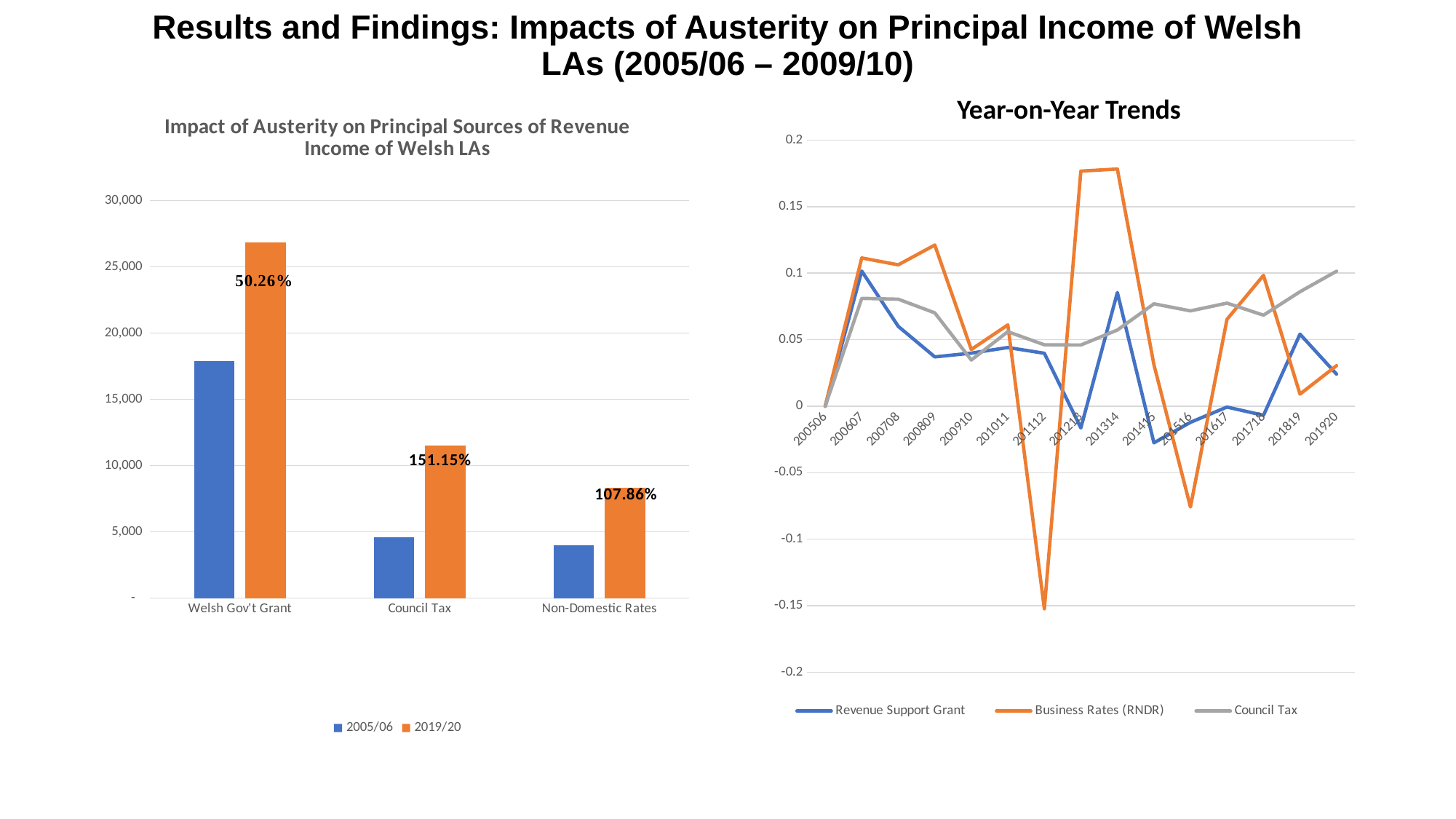
In the left bar chart, what percentage label is printed above the Non-Domestic Rates bars? 107.86% In the right chart 'Year-on-Year Trends', how many series does the legend list? 3 In the left bar chart, what percentage label is printed above the Council Tax bars? 151.15% In the left bar chart, how many categories are shown on the x axis? 3 In the left bar chart, how many series does the legend list? 2 In the left bar chart, is the 2005/06 value for Welsh Gov't Grant greater or less than 15,000? greater In the right chart 'Year-on-Year Trends', how many years are shown on the x axis? 15 What kind of chart is the right chart, 'Year-on-Year Trends'? Line chart In the right chart 'Year-on-Year Trends', is the Business Rates (RNDR) value for 201112 greater or less than -0.1? less In the left bar chart, what percentage label is printed above the Welsh Gov't Grant bars? 50.26% In the left bar chart, which category has the highest 2019/20 bar? Welsh Gov't Grant What kind of chart is the left chart, 'Impact of Austerity on Principal Sources of Revenue Income of Welsh LAs'? Bar chart